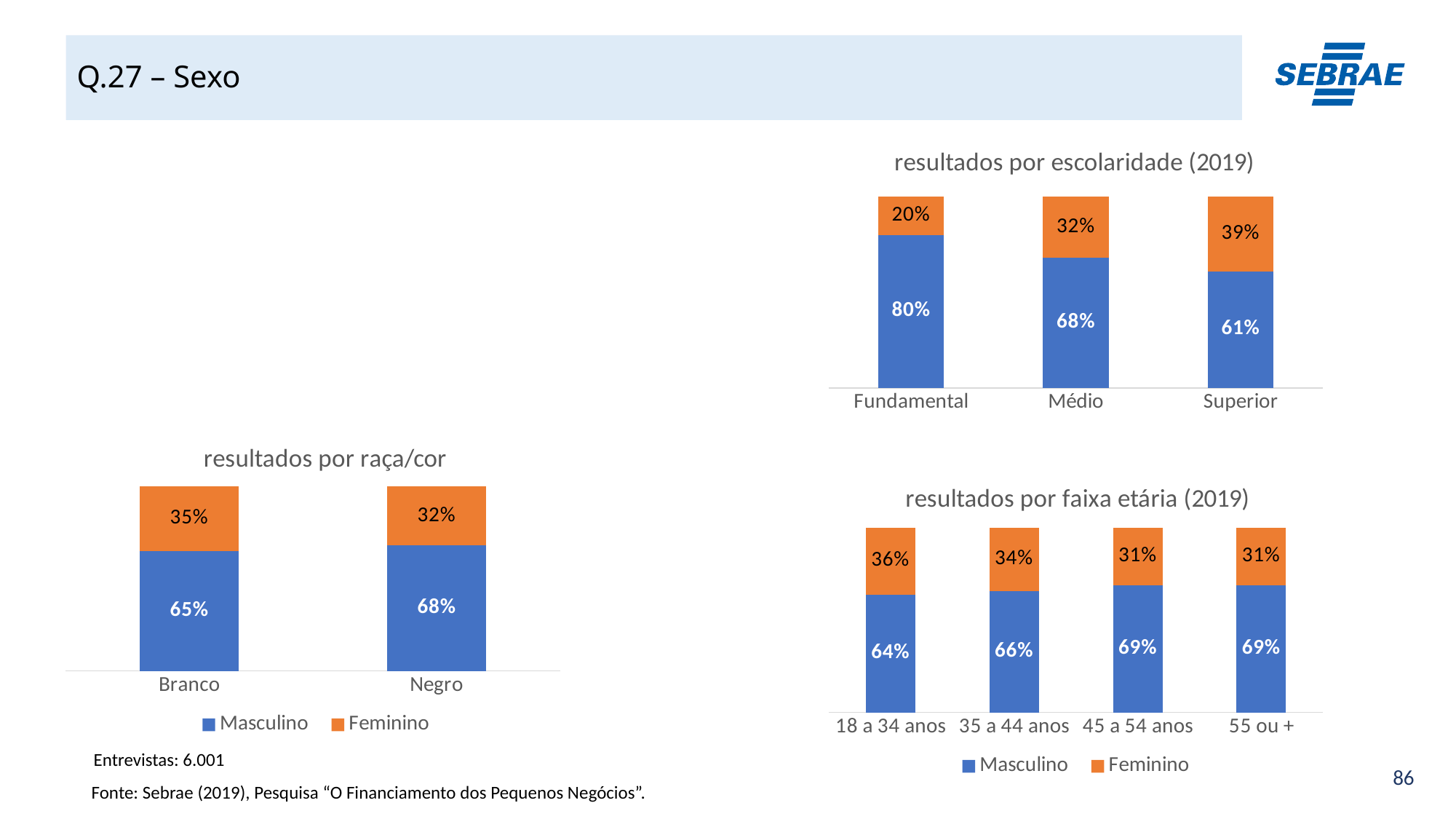
In the 'resultados por raça/cor' chart, what is the Feminino value for Negro? 32% In the 'resultados por faixa etária (2019)' chart, how many age categories are shown? 4 In the 'resultados por faixa etária (2019)' chart, what is the Feminino value for 18 a 34 anos? 36% What kind of chart is the 'resultados por escolaridade (2019)' chart? stacked bar chart In the 'resultados por escolaridade (2019)' chart, what is the Masculino value for Fundamental? 80% In the 'resultados por escolaridade (2019)' chart, does the Masculino value rise or fall from Fundamental to Superior? fall In the 'resultados por faixa etária (2019)' chart, which is larger, the Masculino value for 18 a 34 anos or for 45 a 54 anos? 45 a 54 anos How many series does the legend of the 'resultados por raça/cor' chart list? 2 In the 'resultados por raça/cor' chart, what is the difference between the Masculino values for Negro and Branco? 3% In the 'resultados por escolaridade (2019)' chart, which category has the highest Feminino value? Superior In the 'resultados por escolaridade (2019)' chart, which category has the lowest Masculino value? Superior In the 'resultados por raça/cor' chart, what is the Masculino value for Branco? 65%